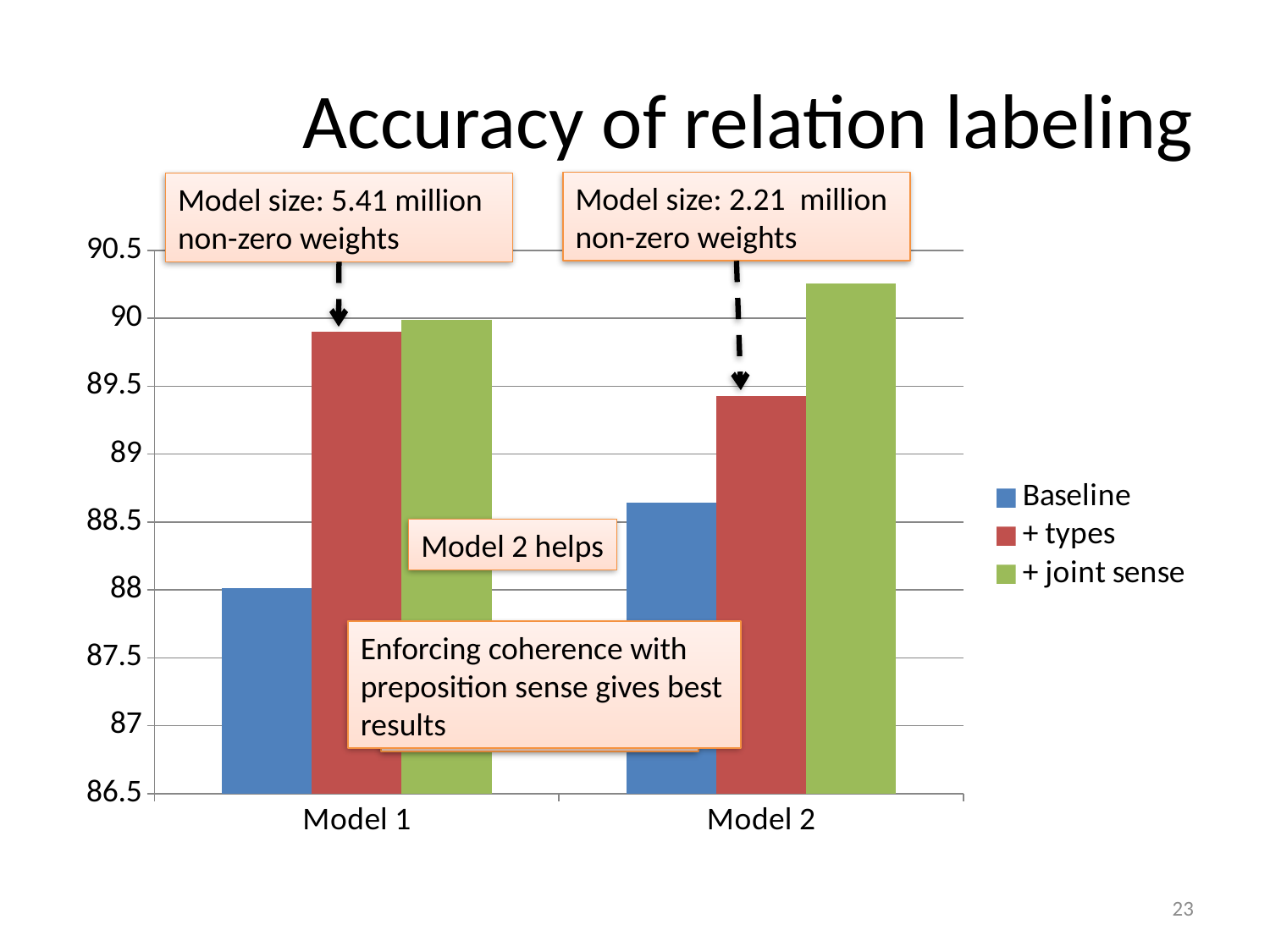
How many categories are shown on the x axis? 2 What is the title of the chart? Accuracy of relation labeling Is the Baseline value for Model 2 greater or less than 89? less Which series is shown in blue in the legend? Baseline What kind of chart is shown on the slide? bar chart Which has the higher + types value, Model 1 or Model 2? Model 1 Is the + types value for Model 1 greater or less than 89.5? greater Which has the higher Baseline value, Model 1 or Model 2? Model 2 Which bar is the lowest in the chart? Baseline for Model 1 Is the + joint sense value for Model 2 greater or less than 90? greater How many series does the legend list? 3